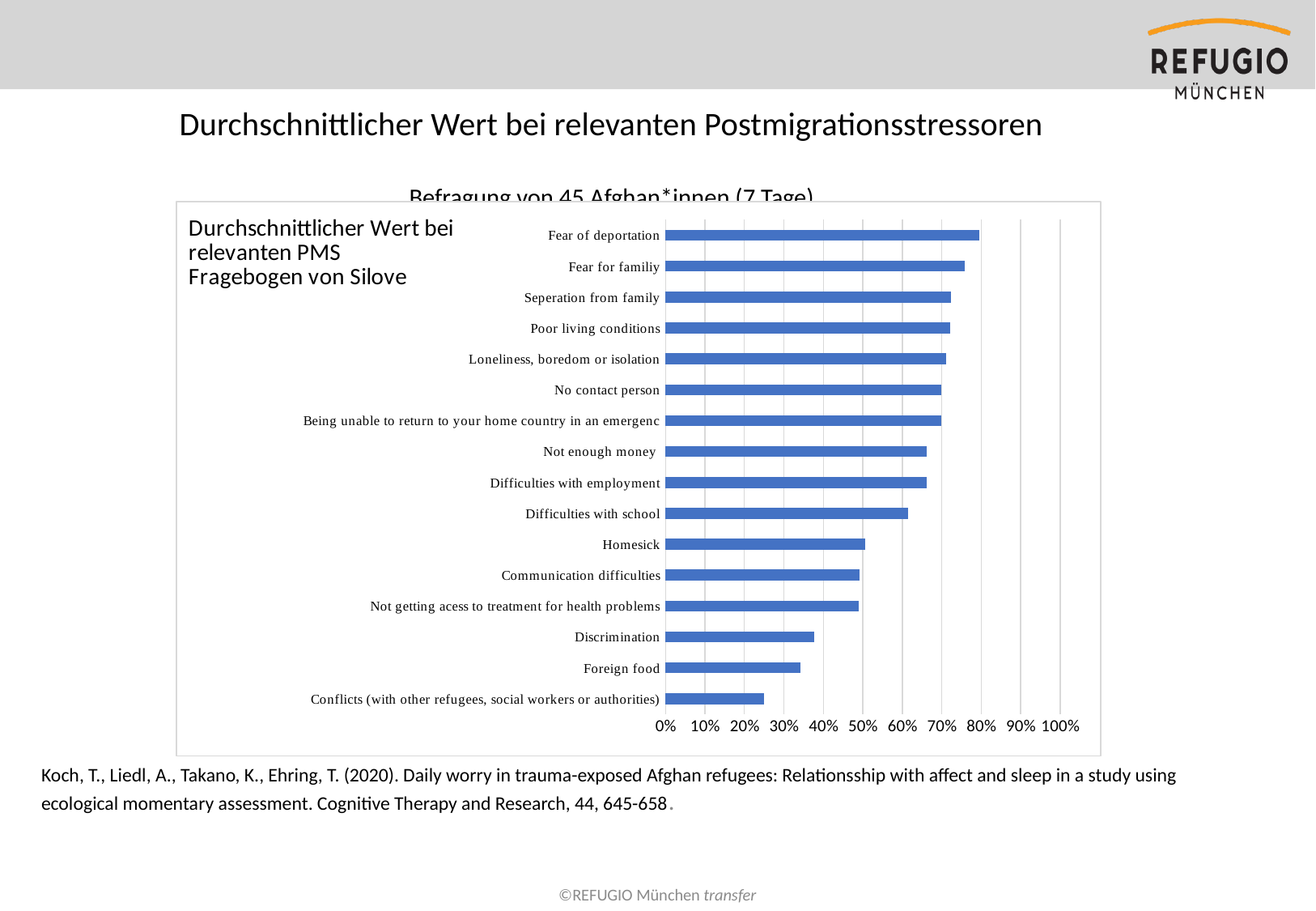
Which has a larger value, Fear for familiy or Seperation from family? Fear for familiy Which category has the highest value in the chart? Fear of deportation Is the value for Foreign food greater or less than 40%? less Is the value for Homesick greater or less than 40%? greater Do the bar values increase or decrease going from the top category to the bottom category? decrease Is the value for Not enough money greater or less than 60%? greater What kind of chart is shown on the slide? bar chart How many categories (stressors) are plotted in the chart? 16 Which has a larger value, Discrimination or Foreign food? Discrimination Which category has the lowest value in the chart? Conflicts (with other refugees, social workers or authorities)